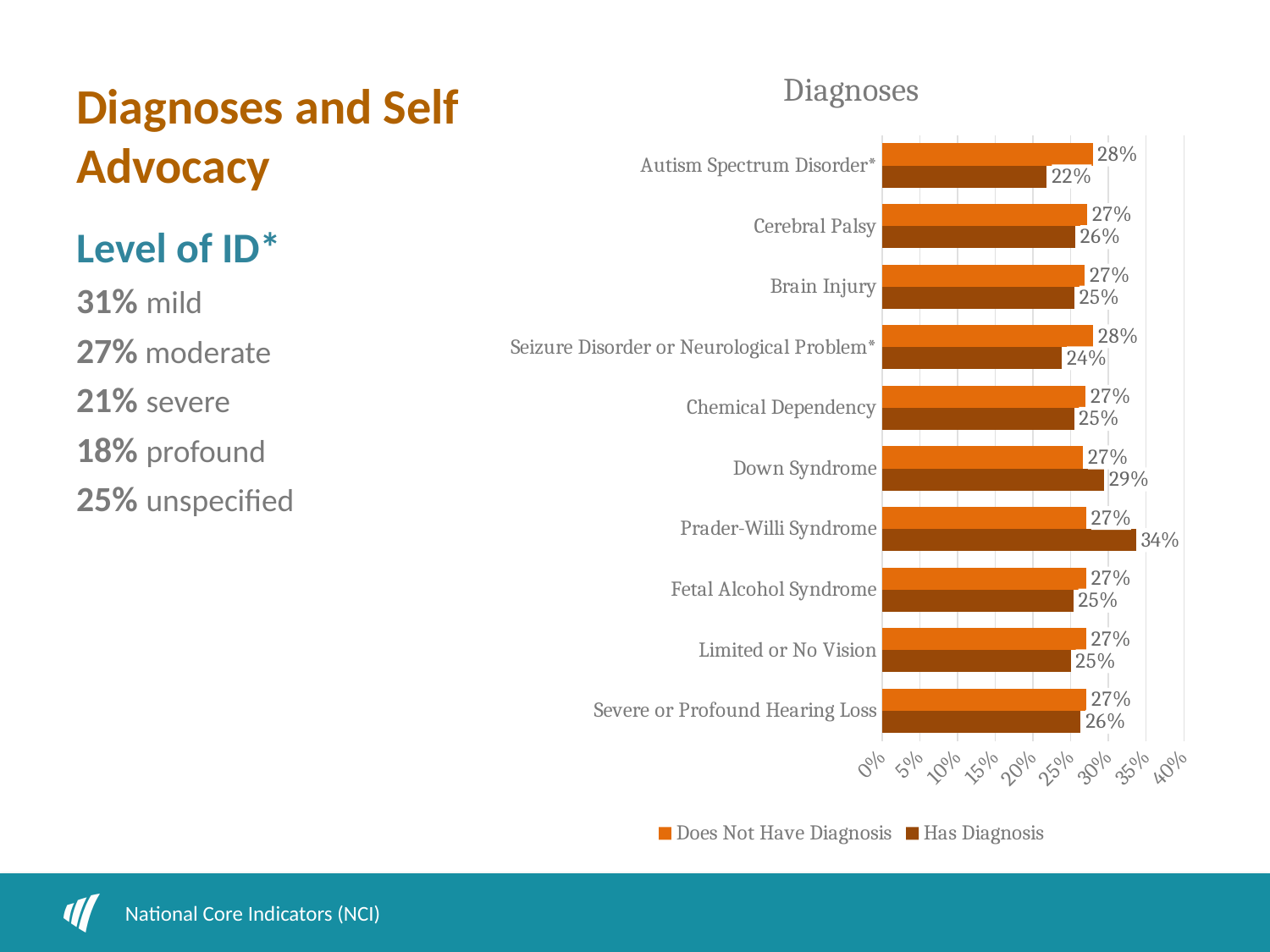
For Down Syndrome, which is larger: 'Has Diagnosis' or 'Does Not Have Diagnosis'? Has Diagnosis What is the difference between the 'Has Diagnosis' and 'Does Not Have Diagnosis' values for Prader-Willi Syndrome? 7% Which category has the lowest 'Has Diagnosis' value? Autism Spectrum Disorder* How many diagnosis categories are shown in the chart? 10 What is the 'Does Not Have Diagnosis' value for Autism Spectrum Disorder*? 28% What is the 'Has Diagnosis' value for Prader-Willi Syndrome? 34% How many series does the legend list? 2 What is the title of the chart? Diagnoses What kind of chart is shown on the slide? Bar chart What is the 'Has Diagnosis' value for Down Syndrome? 29% Which category has the highest 'Has Diagnosis' value? Prader-Willi Syndrome What is the difference between the 'Does Not Have Diagnosis' and 'Has Diagnosis' values for Autism Spectrum Disorder*? 6%